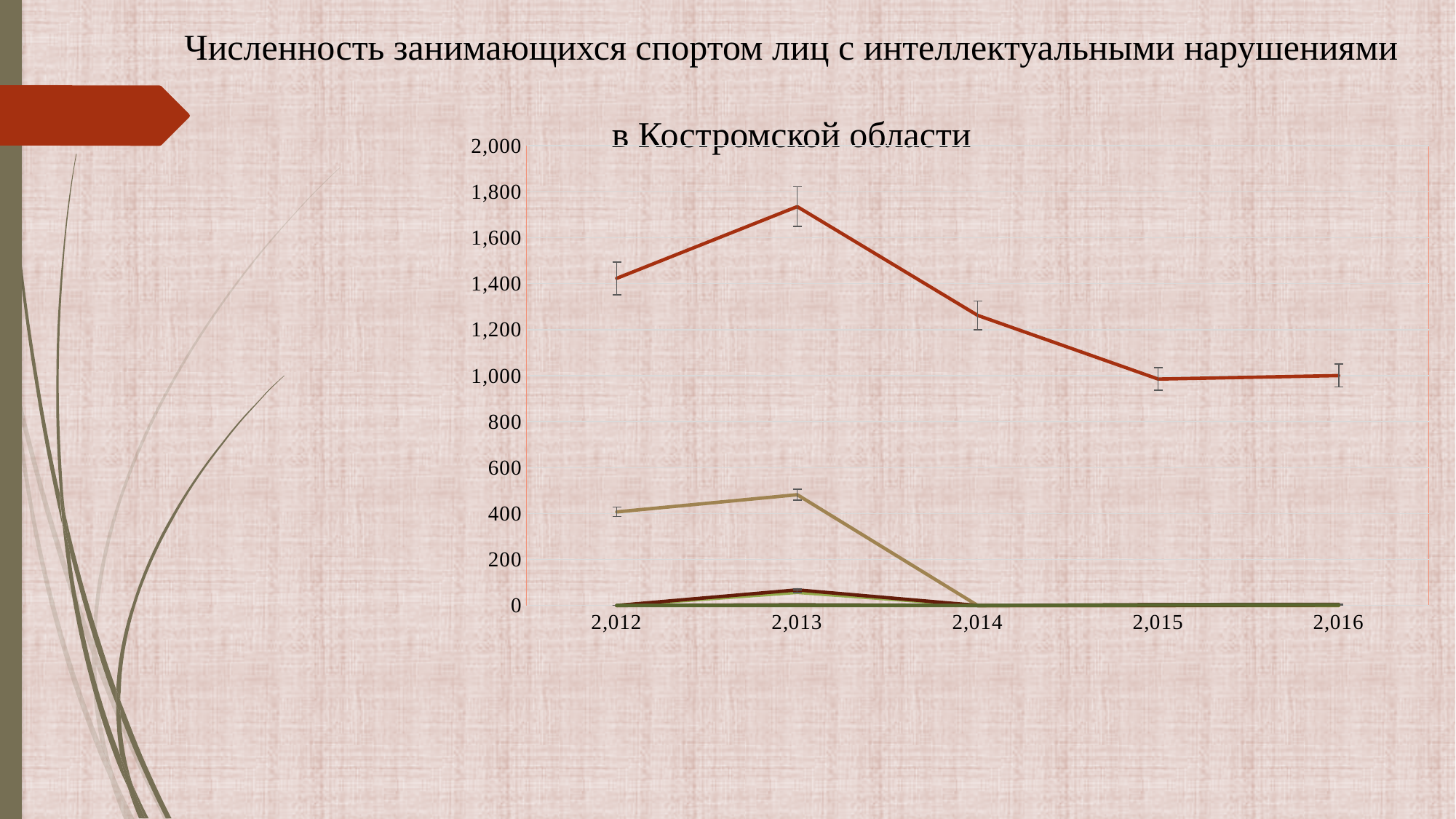
How many years are shown on the x axis of the chart? 5 Does the red (top) line rise or fall between 2,013 and 2,015? fall Is the value of the red (top) line in 2,014 greater or less than 1,400? less Is the value of the red (top) line in 2,012 greater or less than 1,200? greater Is the value of the tan (second) line in 2,014 greater or less than 200? less What is the highest value shown on the y axis of the chart? 2,000 Which is larger in 2,012: the value of the red (top) line or the tan (second) line? the red (top) line What kind of chart is shown on the slide? line chart In which year does the red (top) line reach its highest value? 2,013